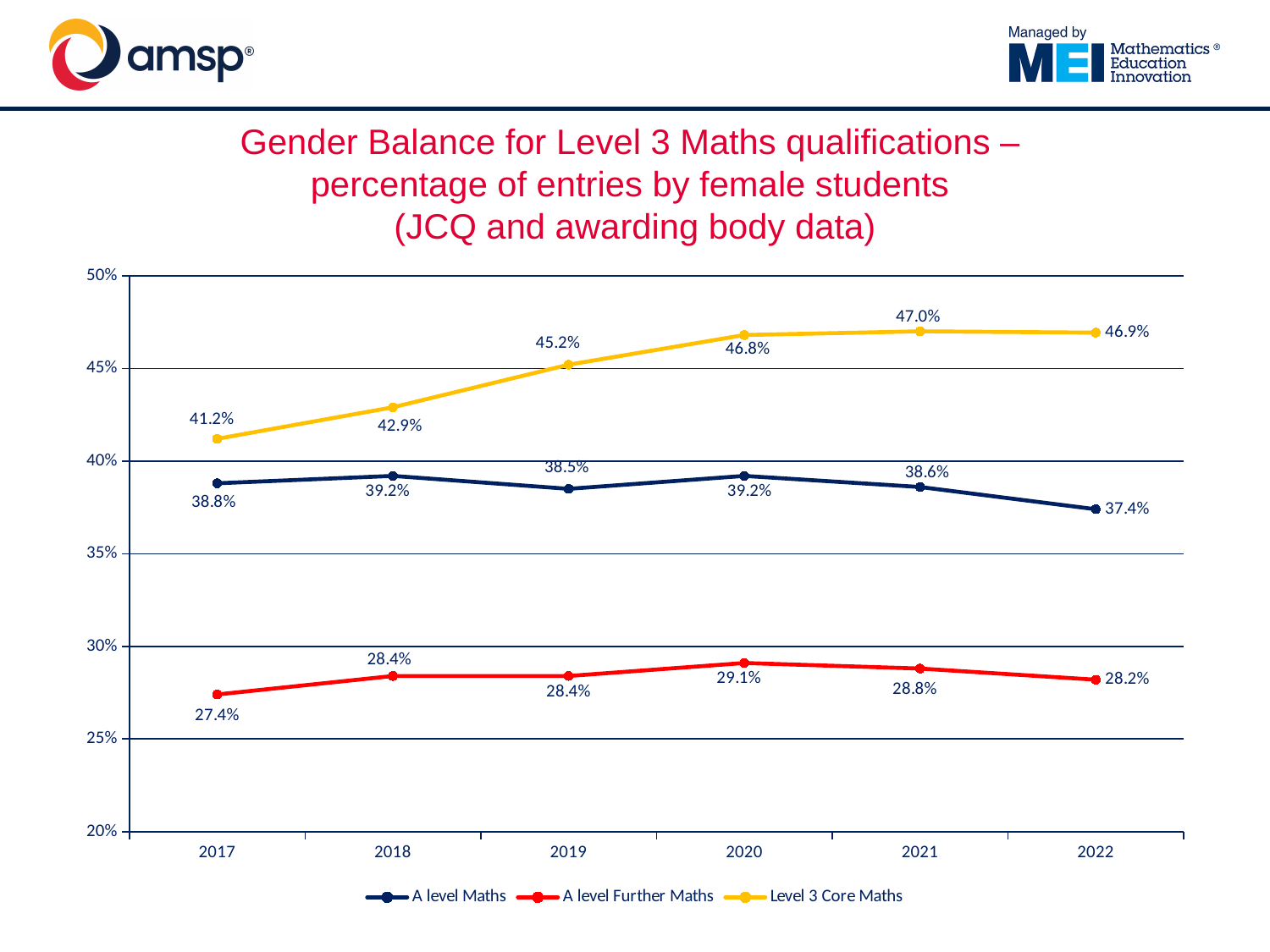
Which series had the higher value in 2020: A level Maths or A level Further Maths? A level Maths What was the A level Maths value in 2022? 37.4% Is the A level Further Maths value for 2020 greater or less than 30%? less What was the A level Further Maths value in 2017? 27.4% Did the Level 3 Core Maths percentage rise or fall between 2017 and 2021? rise How many years are shown on the x axis? 6 How many series does the legend list? 3 What percentage of Level 3 Core Maths entries were by female students in 2019? 45.2% What kind of chart is shown on the slide? line chart In which year was the Level 3 Core Maths percentage highest? 2021 What is the difference between the Level 3 Core Maths value in 2022 and the A level Maths value in 2022? 9.5% In which year was the A level Further Maths percentage lowest? 2017